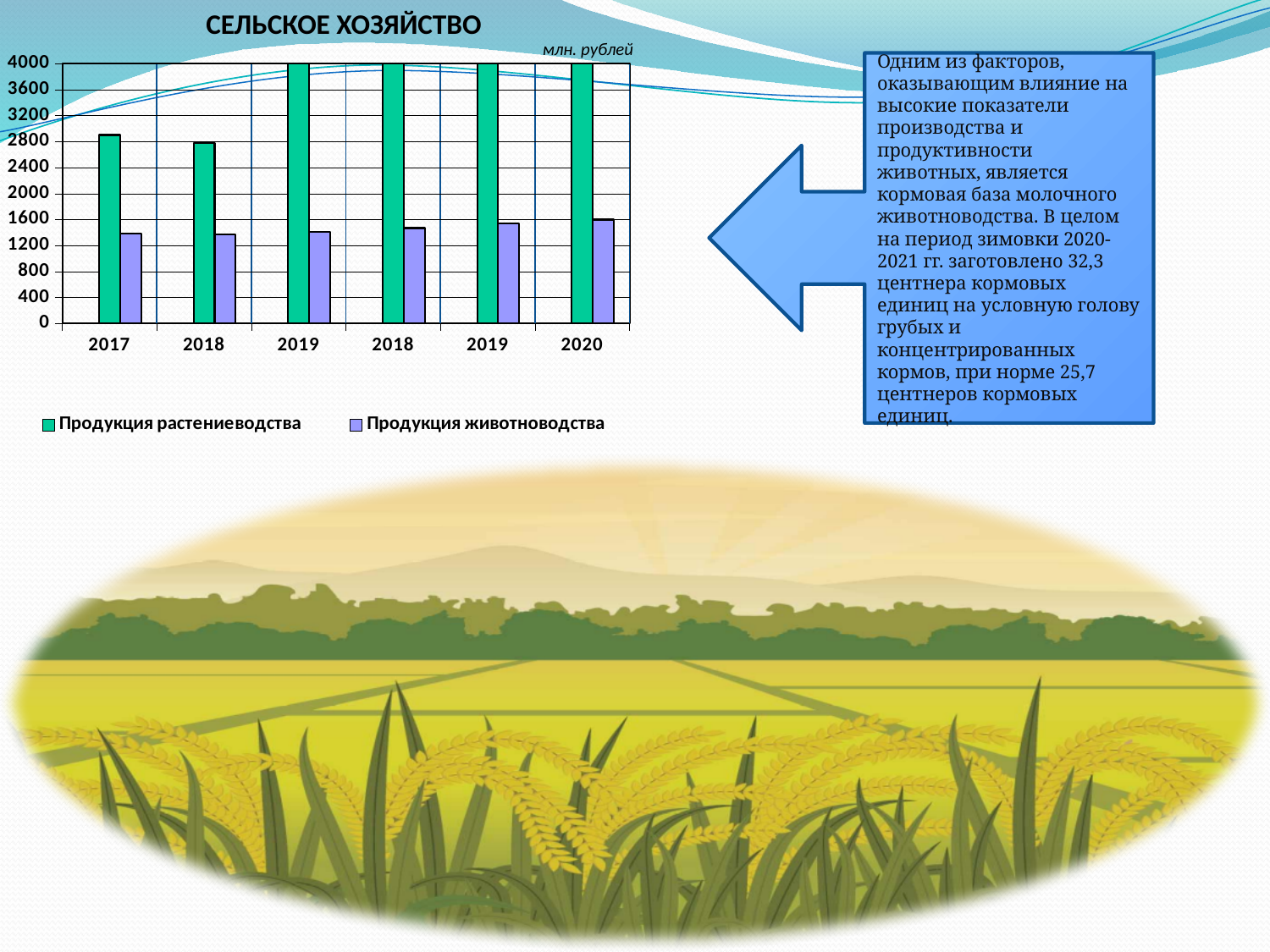
Do the values for Продукция животноводства generally rise or fall from left to right along the x axis? rise What unit is indicated above the chart's y axis? млн. рублей How many category groups are shown along the x axis? 6 What kind of chart is shown on the slide? bar chart Is the value for Продукция животноводства in 2017 greater or less than 1600? less Which is larger: Продукция растениеводства in 2017 or Продукция растениеводства in 2020? 2020 Is the value for Продукция растениеводства in 2020 greater or less than 3600? greater What is the title of the chart? СЕЛЬСКОЕ ХОЗЯЙСТВО Is the value for Продукция растениеводства in 2017 greater or less than 2400? greater In 2017, which series has the larger value: Продукция растениеводства or Продукция животноводства? Продукция растениеводства How many series does the legend list? 2